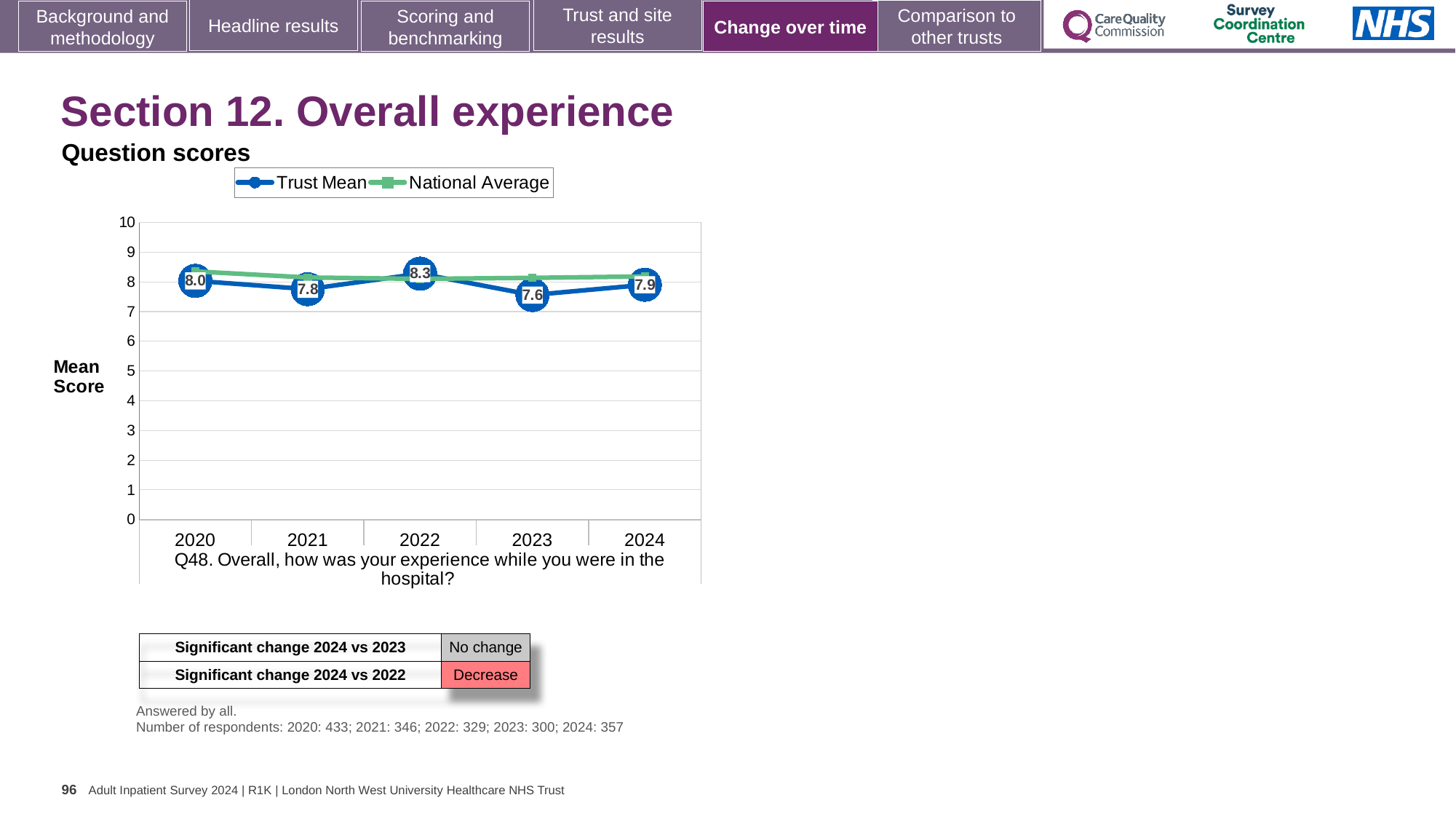
Is the National Average value for 2020 greater or less than 7? greater What is the difference between the Trust Mean scores for 2022 and 2023? 0.7 What is the Trust Mean score for 2022? 8.3 In which year is the Trust Mean score lowest? 2023 Which year has the larger Trust Mean score, 2020 or 2021? 2020 How many years are shown on the x axis of the chart? 5 Does the Trust Mean score rise or fall from 2022 to 2023? fall How many series does the chart legend list? 2 What is the Trust Mean score for 2020? 8.0 In which year is the Trust Mean score highest? 2022 What is the Trust Mean score for 2023? 7.6 What kind of chart is shown on the slide? line chart